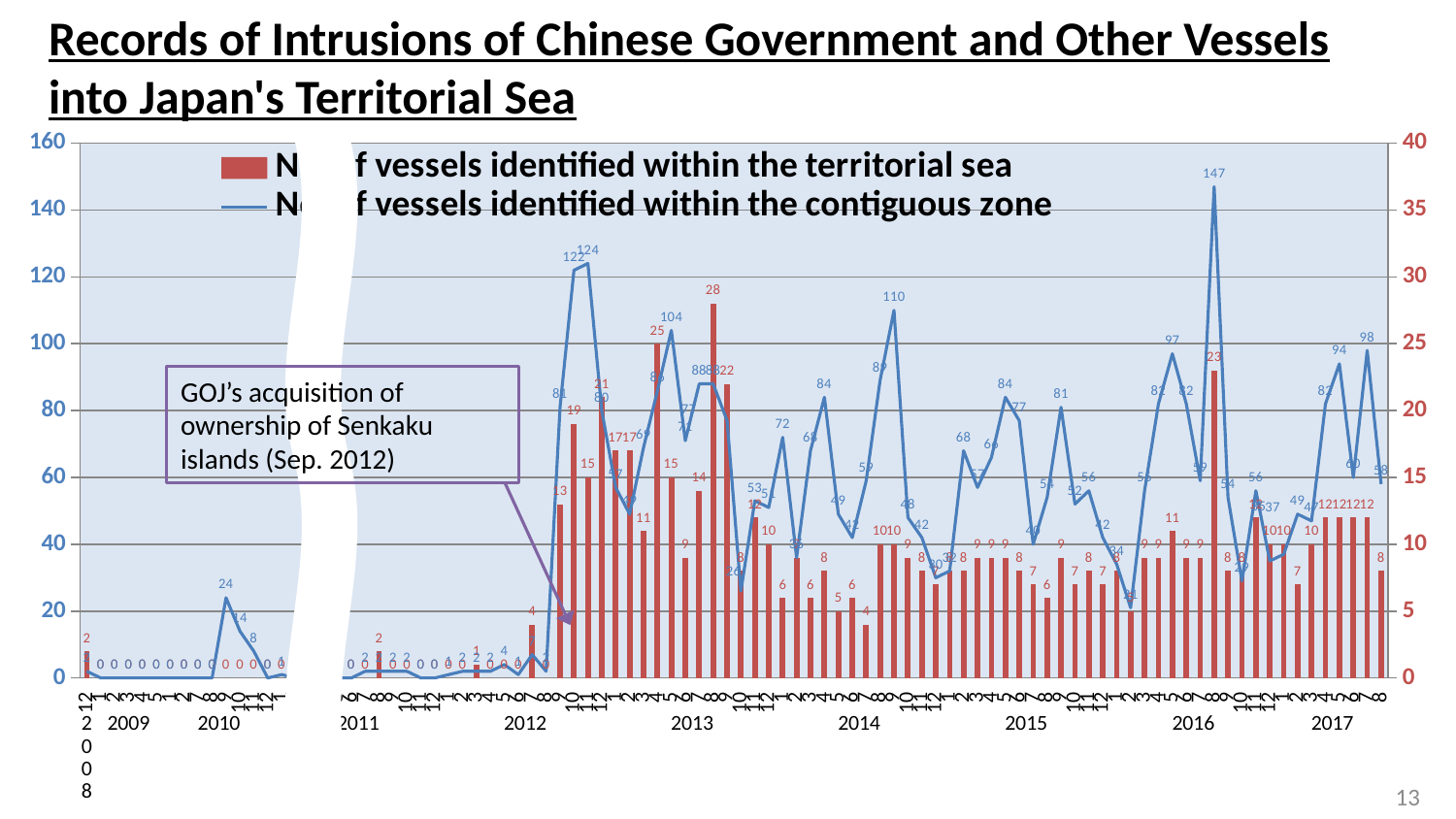
Which series is plotted as bars: vessels within the territorial sea or vessels within the contiguous zone? Vessels within the territorial sea What is the peak value of the contiguous zone line in 2010? 24 What is the maximum value on the left vertical axis? 160 Is the contiguous zone value at its 2016 peak greater or less than 140? greater What kind of chart is shown on the slide? A combination bar and line chart What is the highest monthly value shown for vessels identified within the territorial sea? 28 What is the highest monthly value shown for vessels identified within the contiguous zone? 147 What event does the annotation box on the chart describe? GOJ's acquisition of ownership of Senkaku islands (Sep. 2012) How many series does the chart's legend list? 2 What is the maximum value on the right vertical axis? 40 What is the difference between the two highest contiguous zone values labelled, 147 and 124? 23 Which is larger: the contiguous zone peak of 147 in 2016 or the peak of 124 in 2012? 147 in 2016